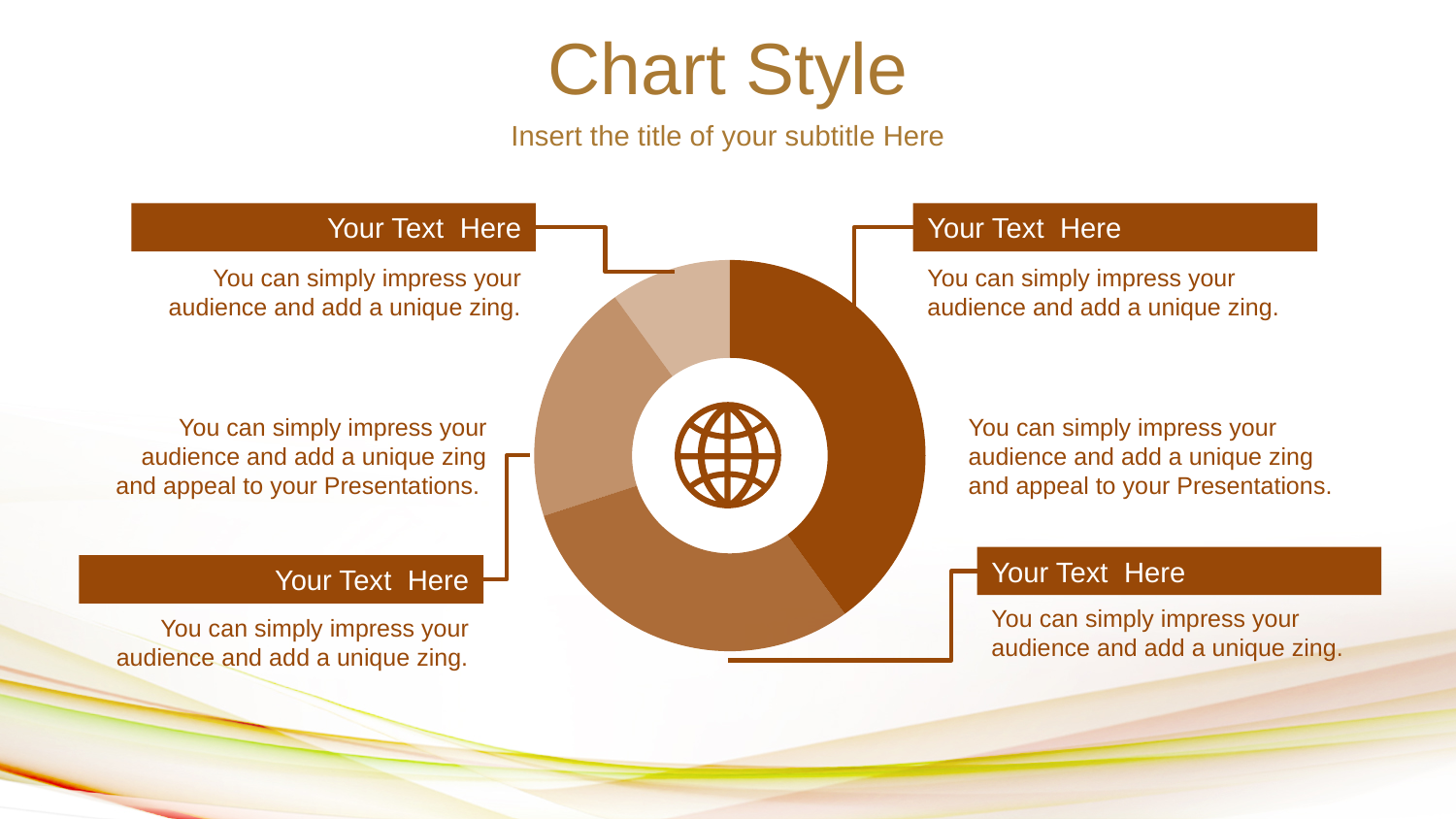
What is the title of the slide containing the chart? Chart Style What kind of chart is shown on the slide? Donut (pie) chart Is the dark brown segment larger than the medium brown segment at the bottom left? Yes What icon appears in the centre of the donut chart? A globe Which segment of the donut chart is the largest? The dark brown segment on the right How many segments does the donut chart have? 4